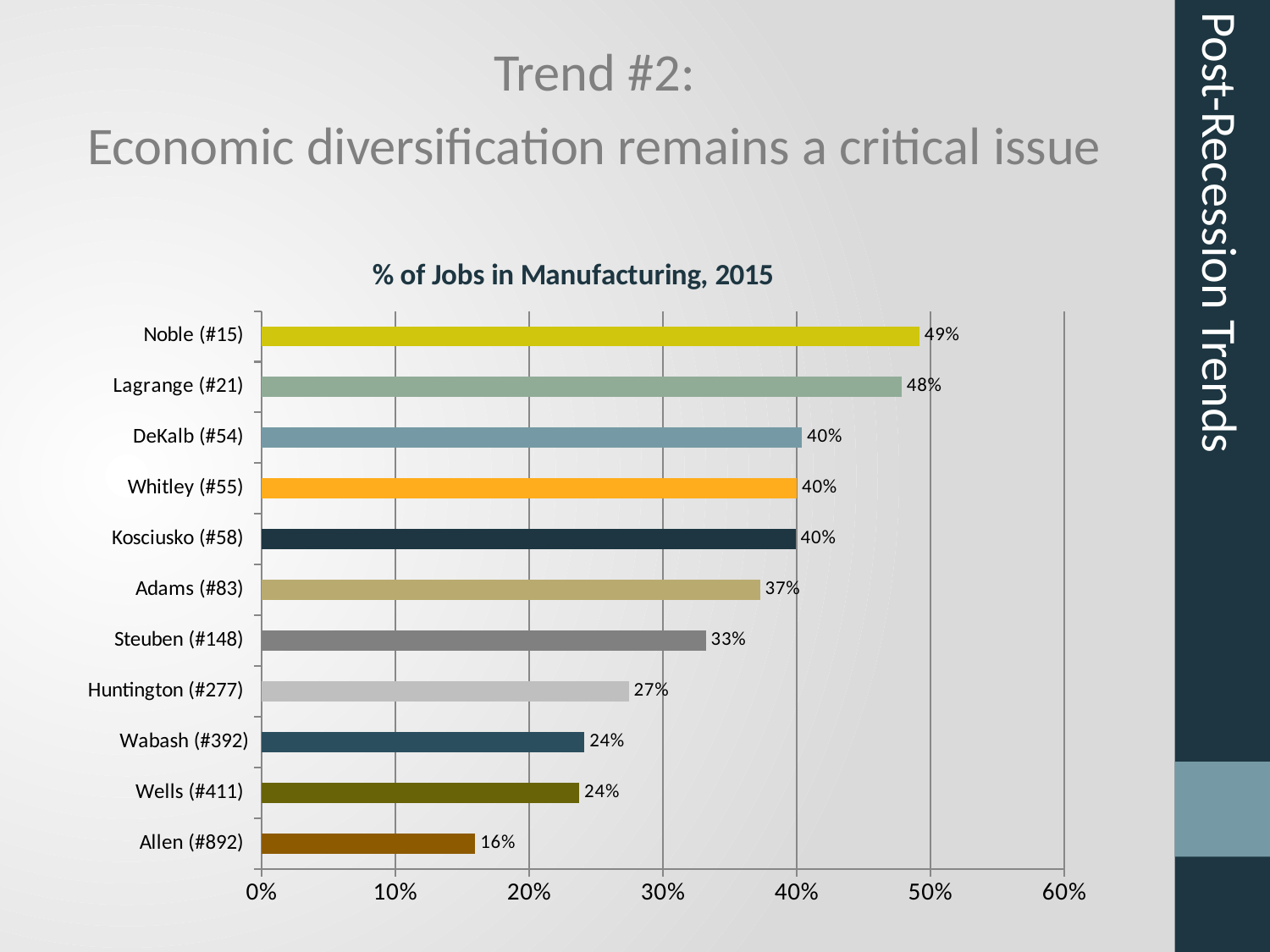
Which county has the lowest % of jobs in manufacturing? Allen (#892) What is the value for Allen (#892)? 16% What is the value for Noble (#15)? 49% What is the value for Steuben (#148)? 33% Which is larger, the value for Lagrange (#21) or the value for Steuben (#148)? Lagrange (#21) What kind of chart is shown on the slide? Bar chart Is the value for Adams (#83) greater or less than 30%? greater What is the title of the chart? % of Jobs in Manufacturing, 2015 Which county has the highest % of jobs in manufacturing? Noble (#15) How many counties are shown in the chart? 11 What is the difference between the values for Adams (#83) and Huntington (#277)? 10% What is the difference between the values for Noble (#15) and Allen (#892)? 33%